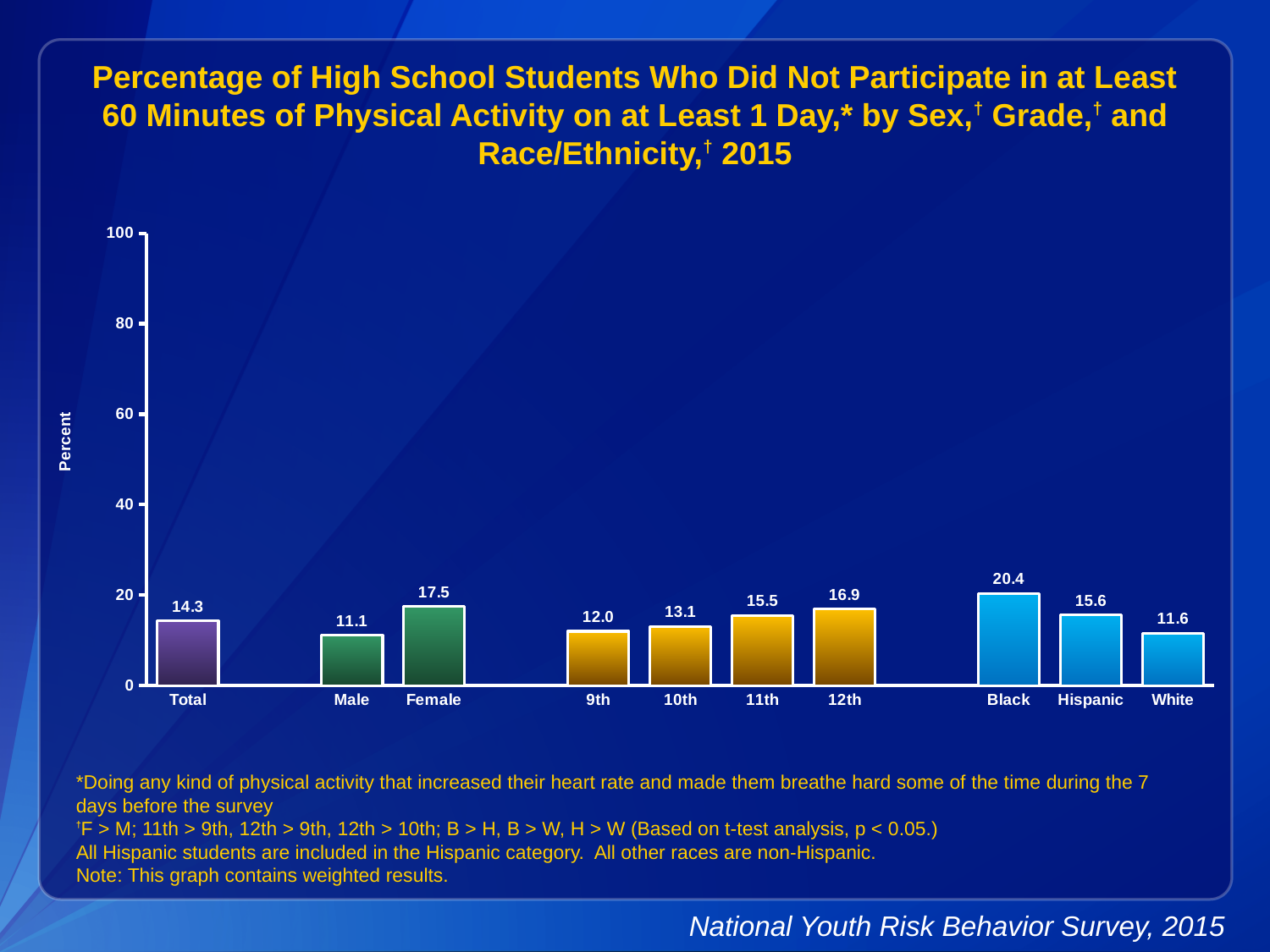
Which category has the highest value? Black Which is larger, the value for 11th grade or the value for Hispanic? Hispanic What is the value for Total? 14.3 What is the value for 12th grade? 16.9 Do the values rise or fall from 9th grade to 12th grade? rise What is the difference between the Female and Male values? 6.4 What kind of chart is shown on the slide? bar chart How many bars are shown in the chart? 10 Is the value for Black greater or less than 20? greater What is the value for Female? 17.5 Which category has the lowest value? Male What is the difference between the Black and White values? 8.8